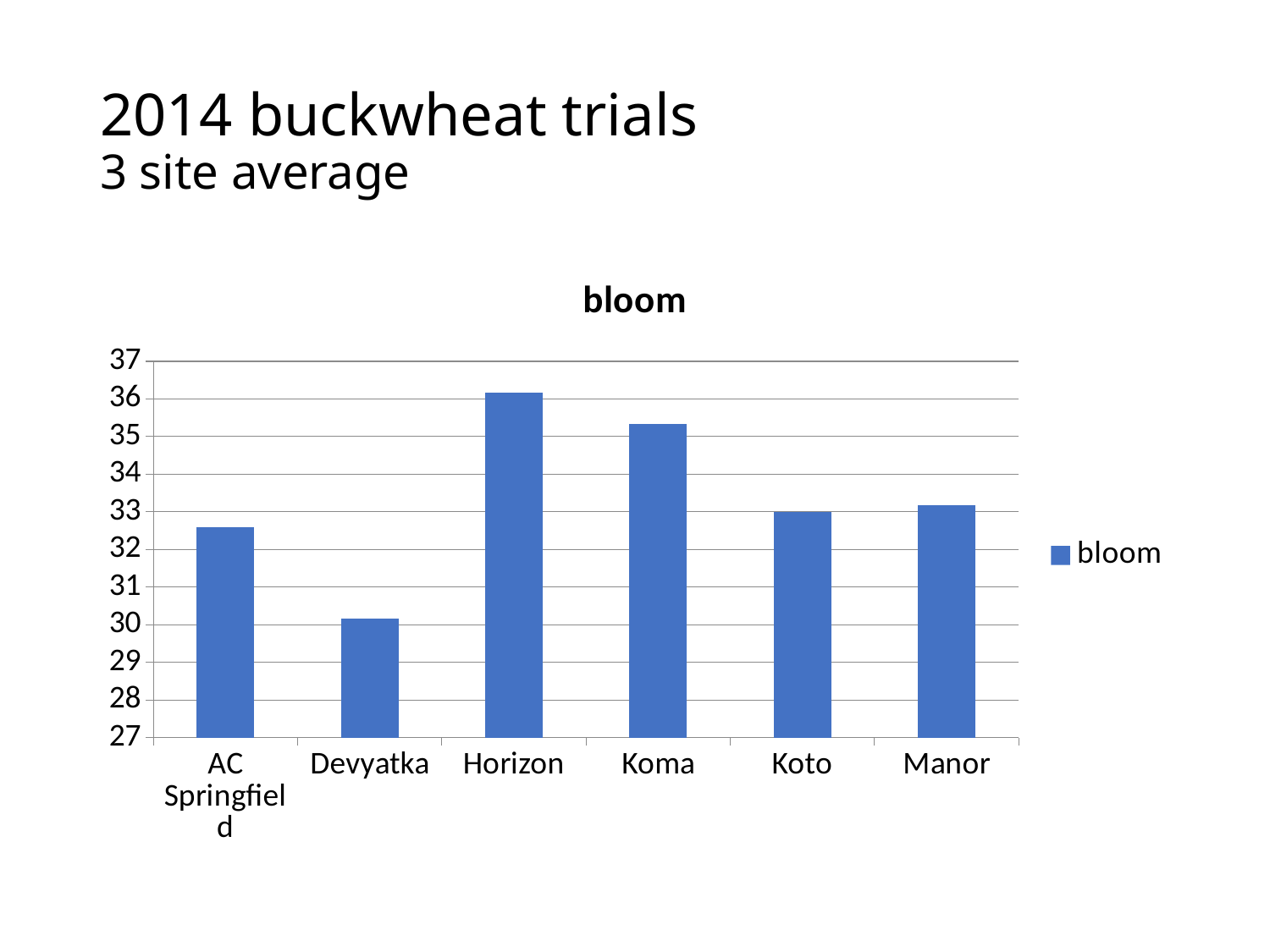
Which has a larger bloom value, Devyatka or AC Springfield? AC Springfield How many series does the legend list? 1 How many varieties (categories) are plotted on the x axis? 6 Is the bloom value for Devyatka greater or less than 31? less Is the bloom value for Horizon greater or less than 35? greater What kind of chart is shown on the slide? bar chart Is the bloom value for Koma greater or less than 36? less What is the title of the chart? bloom Which variety has the highest bloom value? Horizon Which variety has the lowest bloom value? Devyatka Which has a larger bloom value, Horizon or Koma? Horizon